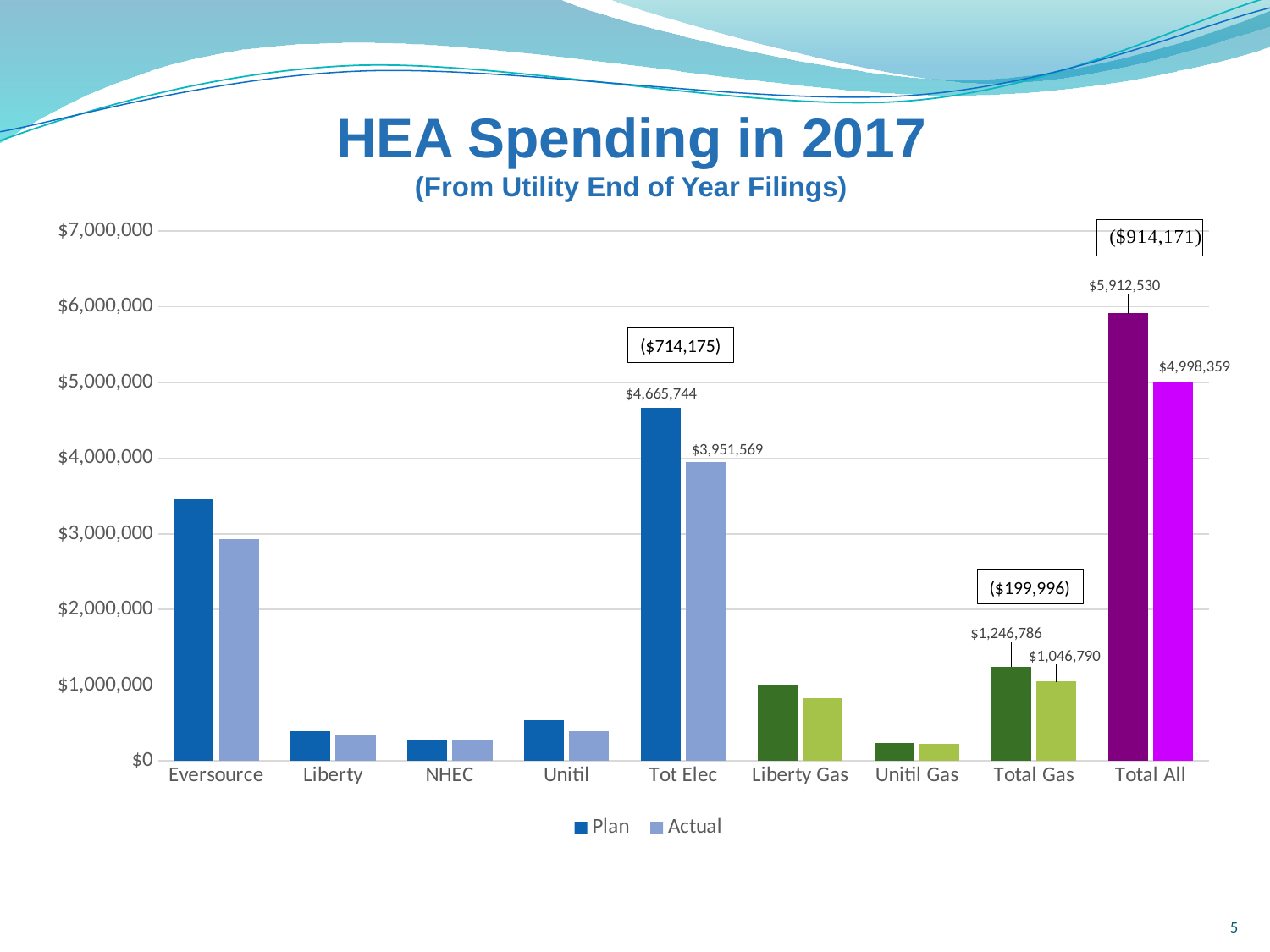
What is the Plan value for Total Gas? $1,246,786 How many series does the legend list? 2 Which category has the highest Plan value? Total All Which category has the lowest Actual value? Unitil Gas What is the Plan value for Tot Elec? $4,665,744 What is the difference between the Plan and Actual values for Total All? $914,171 What is the difference between the Plan and Actual values for Total Gas? $199,996 How many categories are shown on the x axis? 9 Is the Actual value for Liberty Gas greater or less than $1,000,000? less What is the Actual value for Tot Elec? $3,951,569 What is the Actual value for Total All? $4,998,359 Is the Plan value for Eversource greater or less than $3,000,000? greater